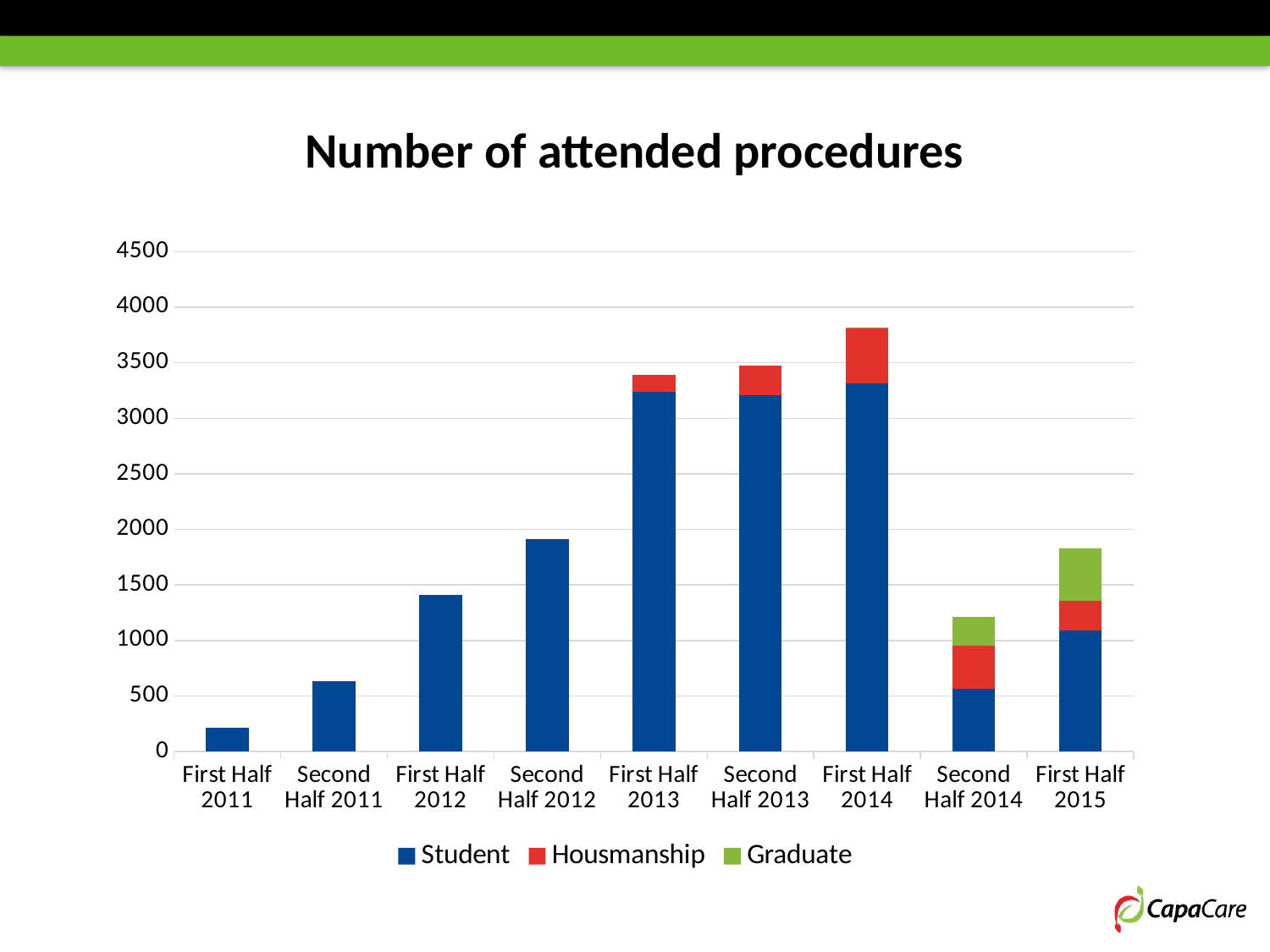
Which period has the highest total number of attended procedures? First Half 2014 How many half-year periods are shown on the x axis? 9 Which has a larger total, Second Half 2014 or First Half 2015? First Half 2015 Do the totals rise or fall from First Half 2011 to First Half 2014? rise What kind of chart is shown on the slide? Stacked bar chart Which period has the lowest total number of attended procedures? First Half 2011 Is the total for First Half 2014 greater or less than 3500? greater What are the three series listed in the legend? Student, Housmanship, Graduate How many series does the legend list? 3 Is the total for First Half 2012 greater or less than 1500? less Which period has the largest Graduate segment? First Half 2015 Is the total for Second Half 2012 greater or less than 1500? greater